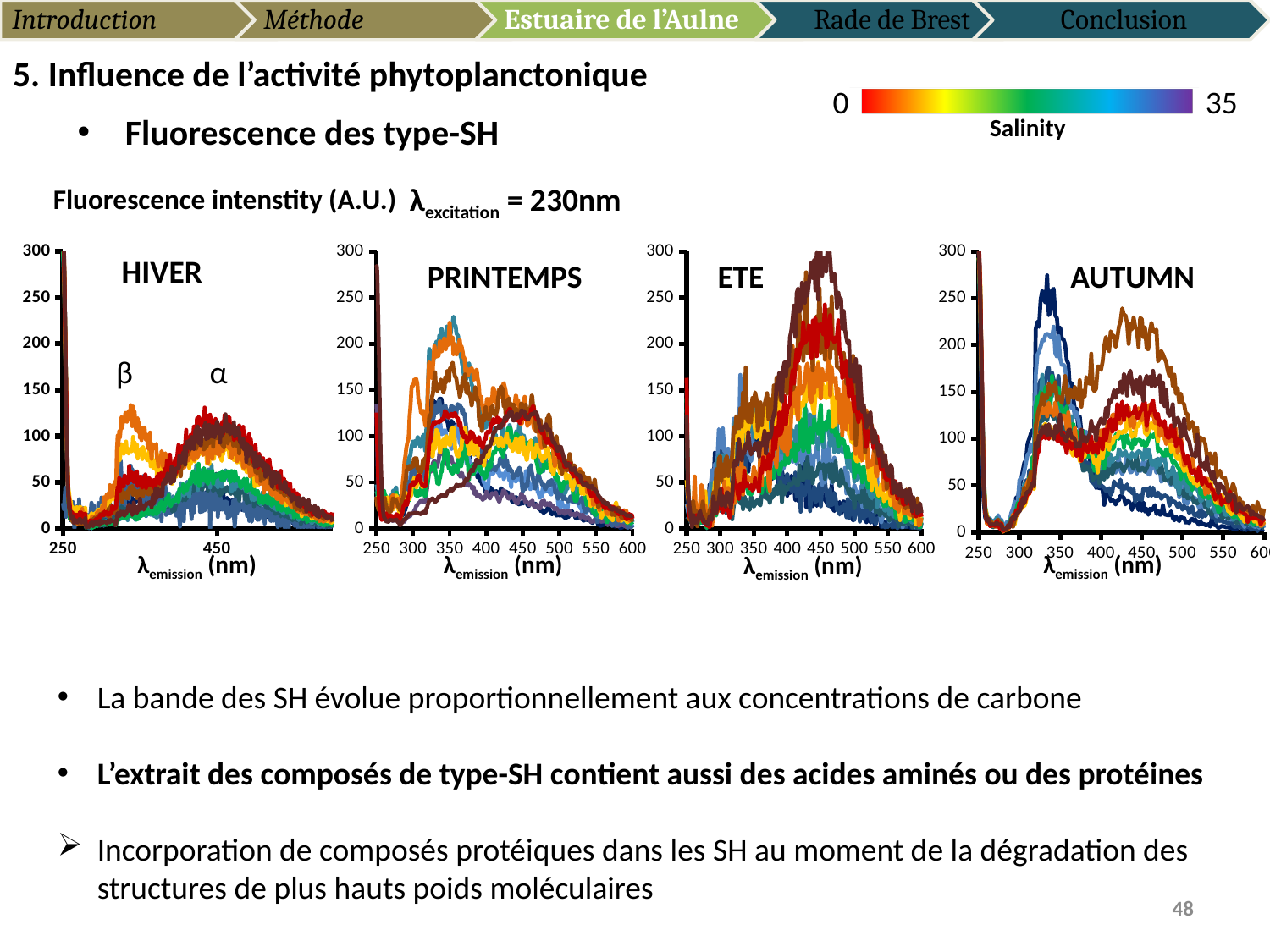
What is the range of the salinity colour scale shown at the top right? 0 to 35 In the PRINTEMPS chart, is the highest peak of the spectra greater or less than 200? greater In the ETE chart, is the highest peak of the spectra greater or less than 250? greater In the HIVER chart, is the highest point of the β band (around 330 nm) greater or less than 150? less Which chart has the highest peak overall, HIVER or ETE? ETE How many charts are shown on the slide? 4 What is the excitation wavelength stated for the fluorescence spectra? 230nm What is the maximum value shown on the y axis of the PRINTEMPS chart? 300 What kind of chart is the HIVER chart? line chart